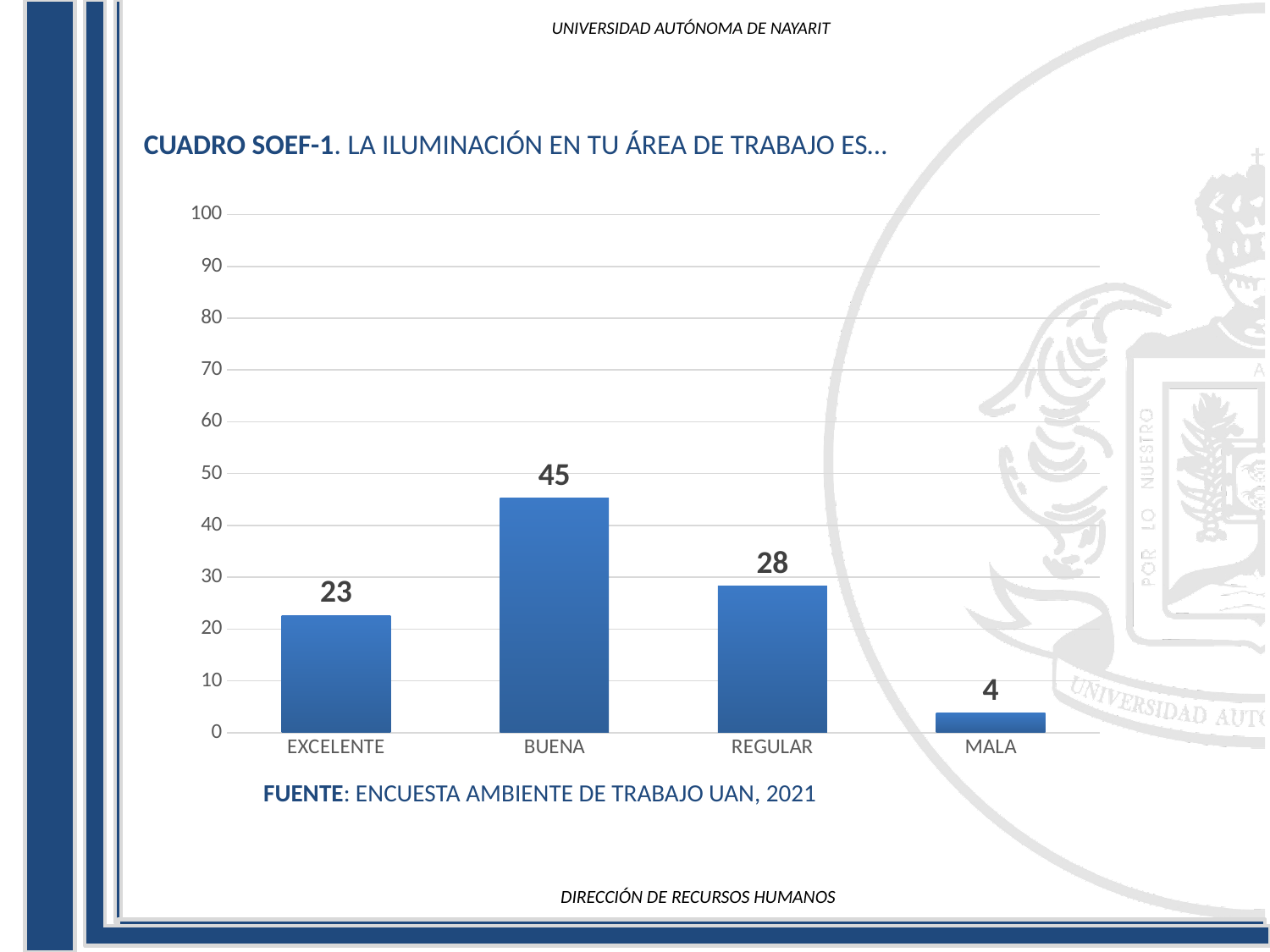
What kind of chart is shown on the slide? bar chart Which category has the highest value? BUENA What is the difference between the values for BUENA and REGULAR? 17 What is the value for EXCELENTE? 23 Which category has the lowest value? MALA How many categories are shown on the x axis? 4 Which is larger, the value for EXCELENTE or the value for REGULAR? REGULAR What source is cited below the chart? ENCUESTA AMBIENTE DE TRABAJO UAN, 2021 What is the value for MALA? 4 What is the total of the values for all four categories? 100 What is the value for BUENA? 45 Is the value for REGULAR greater or less than 30? less